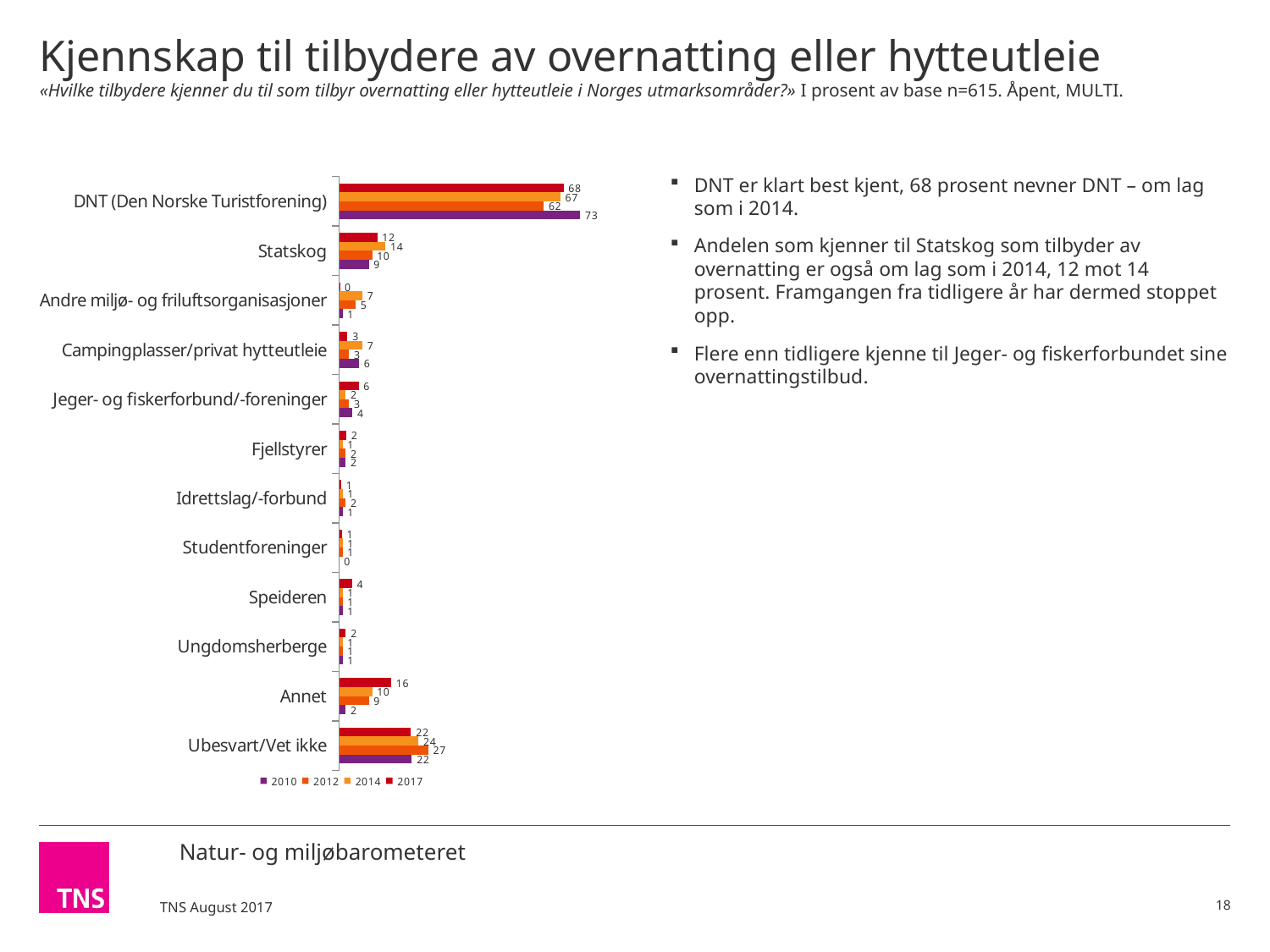
Which category has the highest 2017 value? DNT (Den Norske Turistforening) What is the difference between the 2010 and 2017 values for DNT (Den Norske Turistforening)? 5 What kind of chart is shown on the slide? Bar chart Which is larger for Statskog: the 2014 value or the 2017 value? 2014 What is the 2012 value for Ubesvart/Vet ikke? 27 What is the 2017 value for DNT (Den Norske Turistforening)? 68 What is the 2014 value for Statskog? 14 Which series is shown in purple in the legend? 2010 What is the 2017 value for Annet? 16 What is the 2010 value for DNT (Den Norske Turistforening)? 73 How many categories are shown on the chart? 12 How many series does the legend list? 4